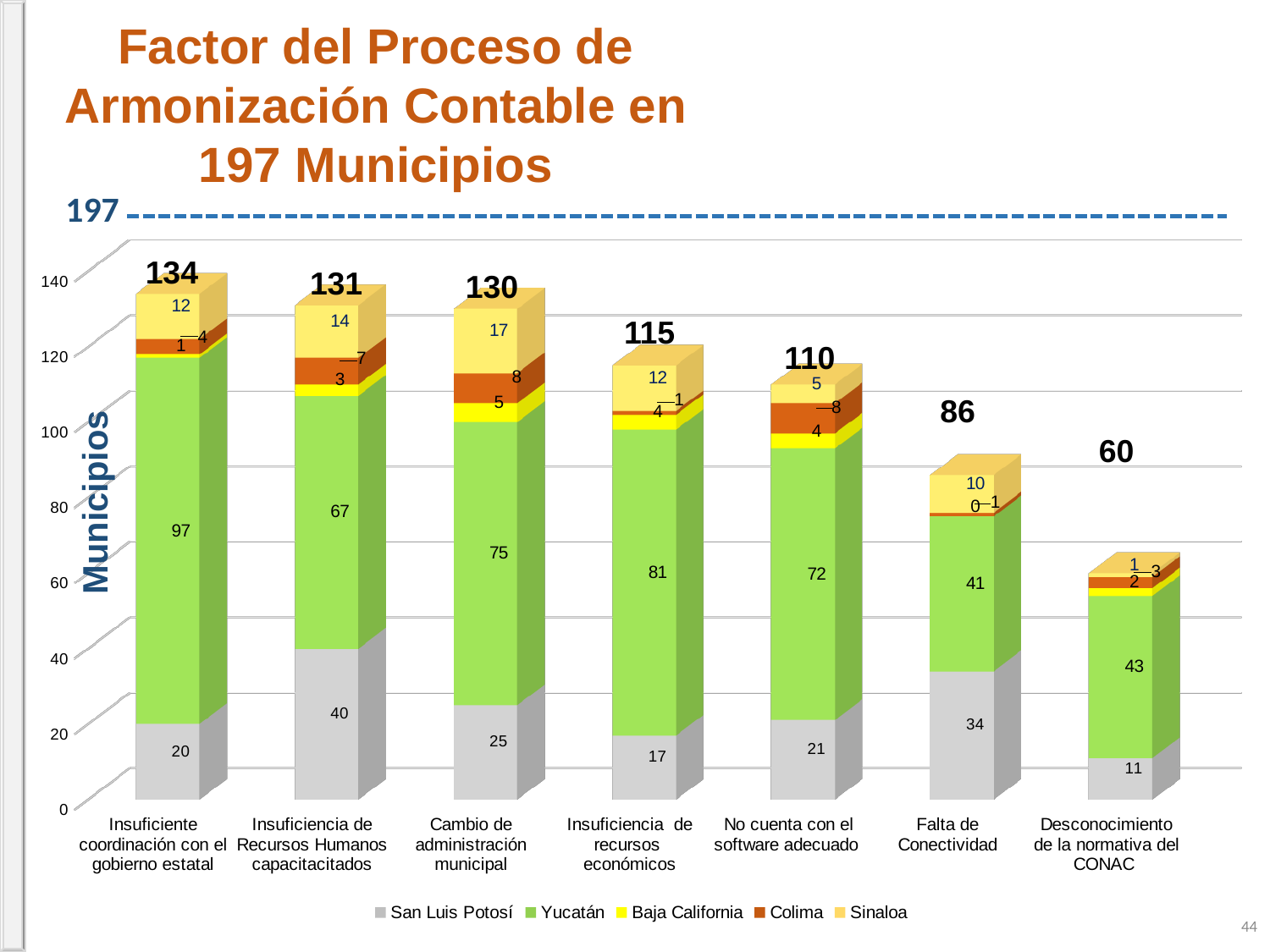
What is the total for the 'Falta de Conectividad' bar? 86 What value does the dashed horizontal line at the top of the chart mark? 197 What is the Sinaloa value for 'No cuenta con el software adecuado'? 5 Which is larger: the Yucatán value for 'Insuficiencia de recursos económicos' or the Yucatán value for 'Falta de Conectividad'? Insuficiencia de recursos económicos Which category has the lowest total? Desconocimiento de la normativa del CONAC How many series does the legend list? 5 What is the Yucatán value for 'Cambio de administración municipal'? 75 What is the difference between the totals for 'Insuficiencia de recursos económicos' and 'No cuenta con el software adecuado'? 5 How many categories are shown on the x axis? 7 What kind of chart is shown on the slide? Stacked bar chart What is the San Luis Potosí value for 'Insuficiencia de Recursos Humanos capacitacitados'? 40 Which category has the highest total? Insuficiente coordinación con el gobierno estatal